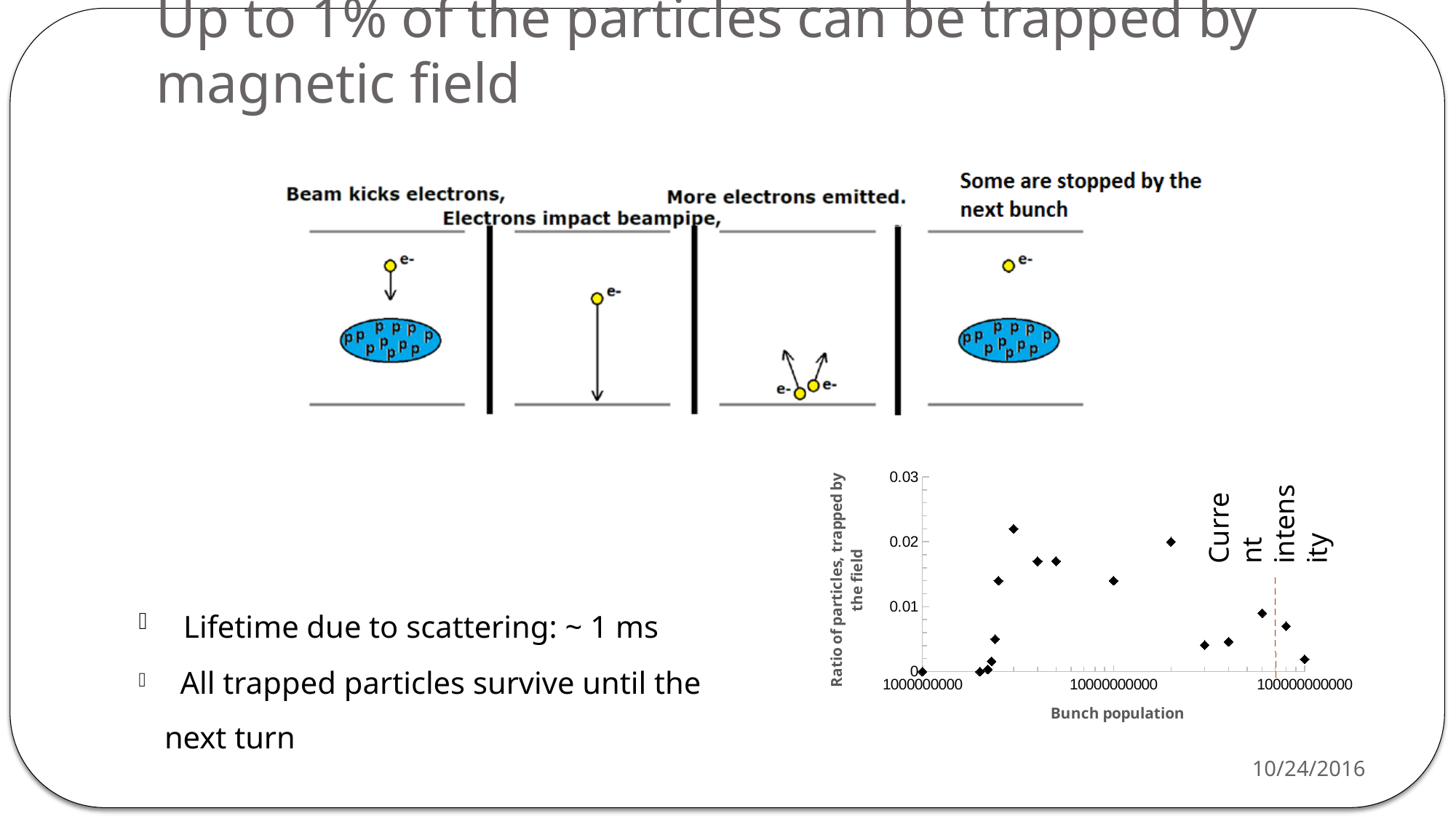
In the scatter chart, is the ratio for the point at a bunch population of 1000000000 greater or less than 0.01? less In the scatter chart, is the highest plotted ratio greater or less than 0.02? greater What is the label of the horizontal axis of the scatter chart? Bunch population What is the maximum value shown on the vertical axis of the scatter chart? 0.03 In the scatter chart, is the ratio for the point at a bunch population of 100000000000 greater or less than 0.01? less In the scatter chart, which is larger: the ratio at a bunch population of about 3000000000 or the ratio at a bunch population of 100000000000? about 3000000000 What is the label of the vertical axis of the scatter chart? Ratio of particles, trapped by the field What kind of chart is shown at the bottom right of the slide? scatter chart